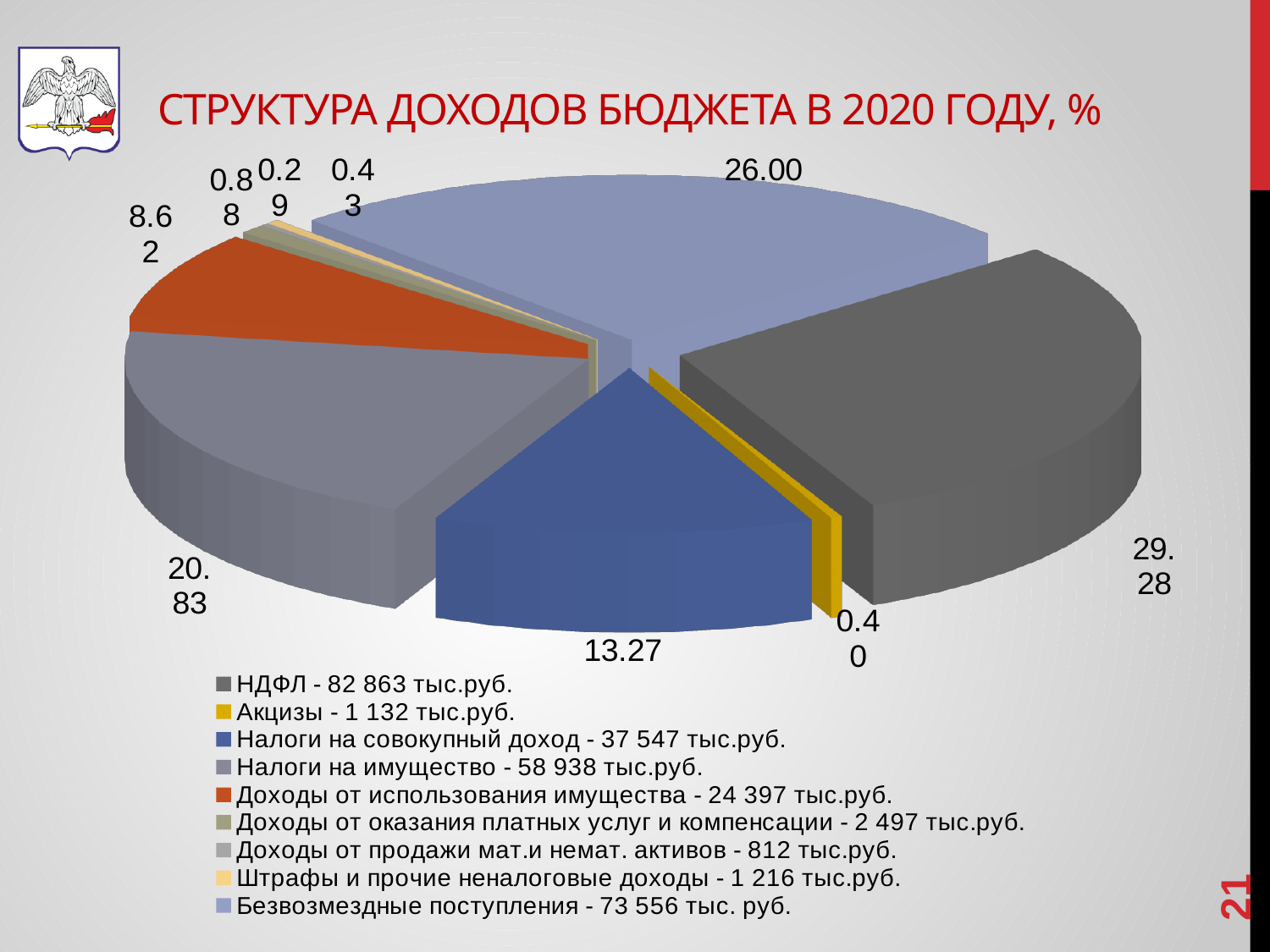
What share of the pie does Безвозмездные поступления - 73 556 тыс. руб. have? 26.00 Which category has the smallest slice of the pie? Доходы от продажи мат.и немат. активов - 812 тыс.руб. What share of the pie does Налоги на имущество - 58 938 тыс.руб. have? 20.83 What kind of chart is shown on the slide? pie chart What is the title of the chart? СТРУКТУРА ДОХОДОВ БЮДЖЕТА В 2020 ГОДУ, % Which category has the largest slice of the pie? НДФЛ - 82 863 тыс.руб. What share of the pie does НДФЛ - 82 863 тыс.руб. have? 29.28 How many categories does the legend of the pie chart list? 9 What is the difference between the shares of НДФЛ and Безвозмездные поступления? 3.28 What share of the pie does Доходы от использования имущества - 24 397 тыс.руб. have? 8.62 What share of the pie does Налоги на совокупный доход - 37 547 тыс.руб. have? 13.27 Which is larger: the share of Налоги на имущество or the share of Налоги на совокупный доход? Налоги на имущество